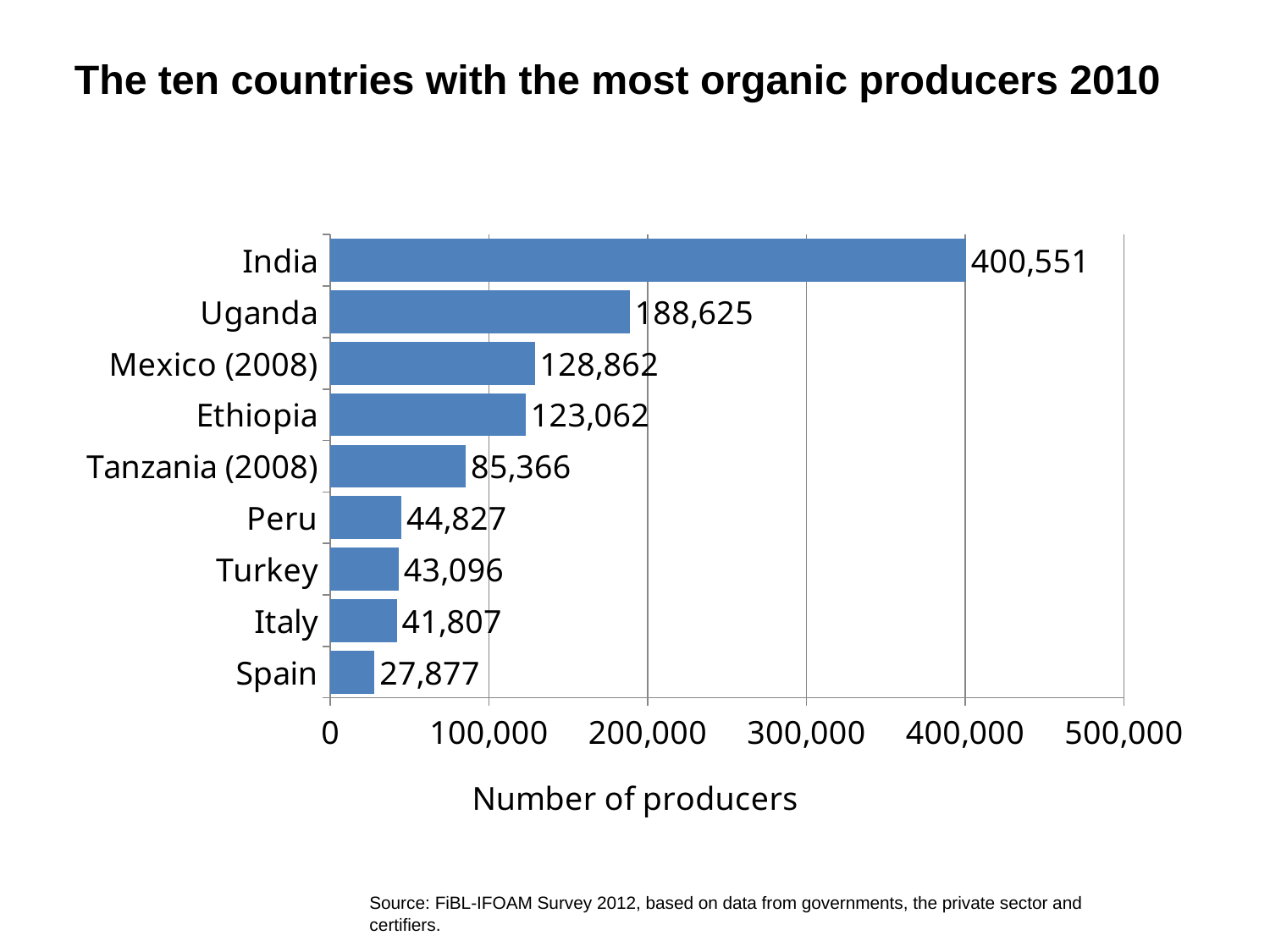
Which has more organic producers, Mexico (2008) or Ethiopia? Mexico (2008) What is the number of organic producers for Tanzania (2008)? 85,366 Which country has the lowest number of organic producers? Spain How many countries are shown in the chart? 9 What is the label of the horizontal axis? Number of producers What is the difference in the number of producers between Italy and Spain? 13,930 Is the value for Uganda greater or less than 200,000? less What is the number of organic producers for Spain? 27,877 What is the difference in the number of producers between India and Uganda? 211,926 What is the number of organic producers for India? 400,551 Which country has the highest number of organic producers? India What kind of chart is shown on the slide? Bar chart